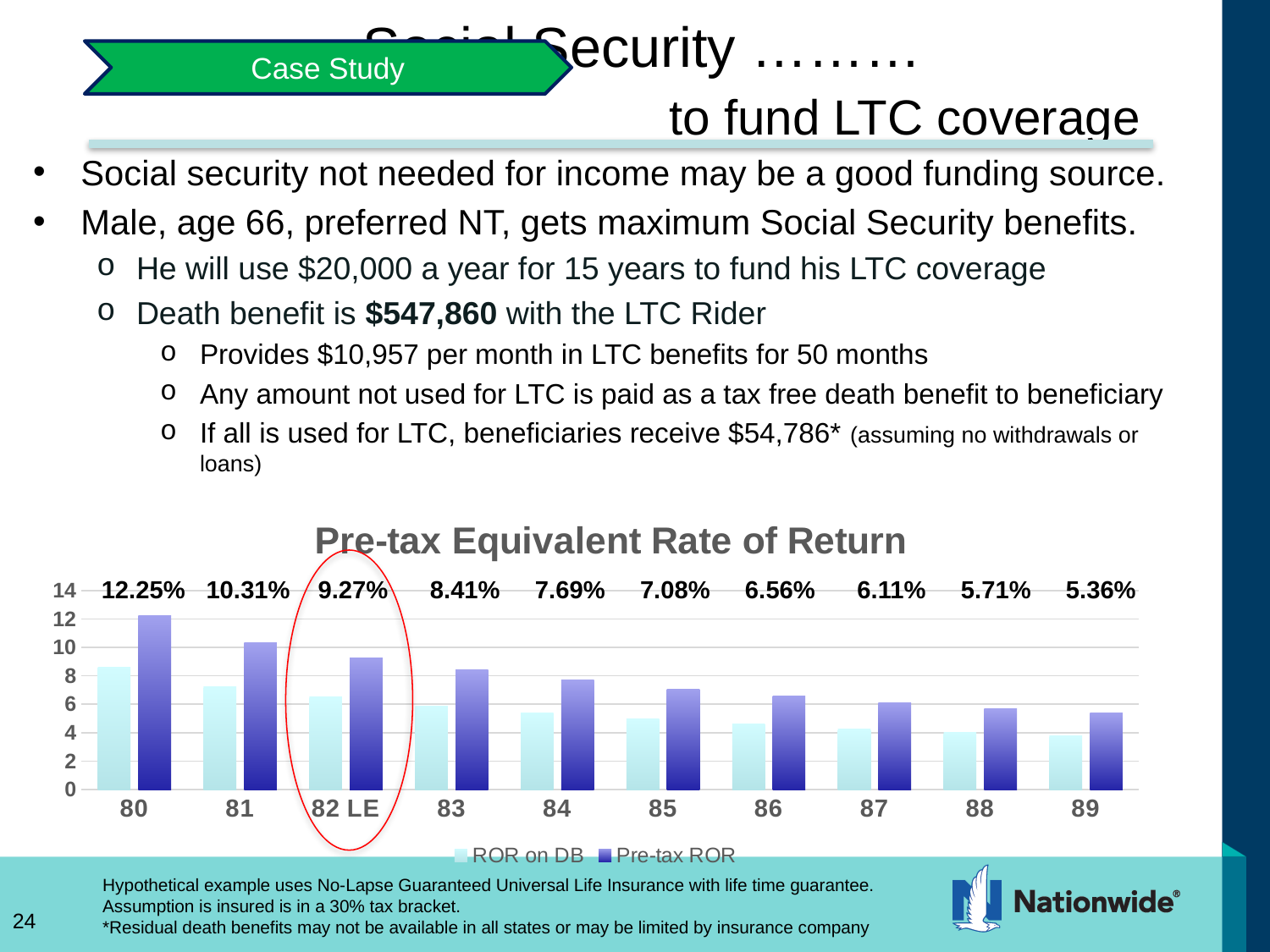
Which is larger, the Pre-tax ROR at age 85 or at age 87? 85 What is the Pre-tax ROR value at age 80? 12.25% What is the Pre-tax ROR value at age 82 LE? 9.27% What is the Pre-tax ROR value at age 89? 5.36% How many series does the legend list? 2 What is the difference between the Pre-tax ROR at age 80 and at age 81? 1.94% What kind of chart is shown on the slide? Bar chart Which age has the lowest Pre-tax ROR? 89 Which age has the highest Pre-tax ROR? 80 How many age categories are shown on the x axis? 10 Is the ROR on DB value at age 80 greater or less than 8? greater